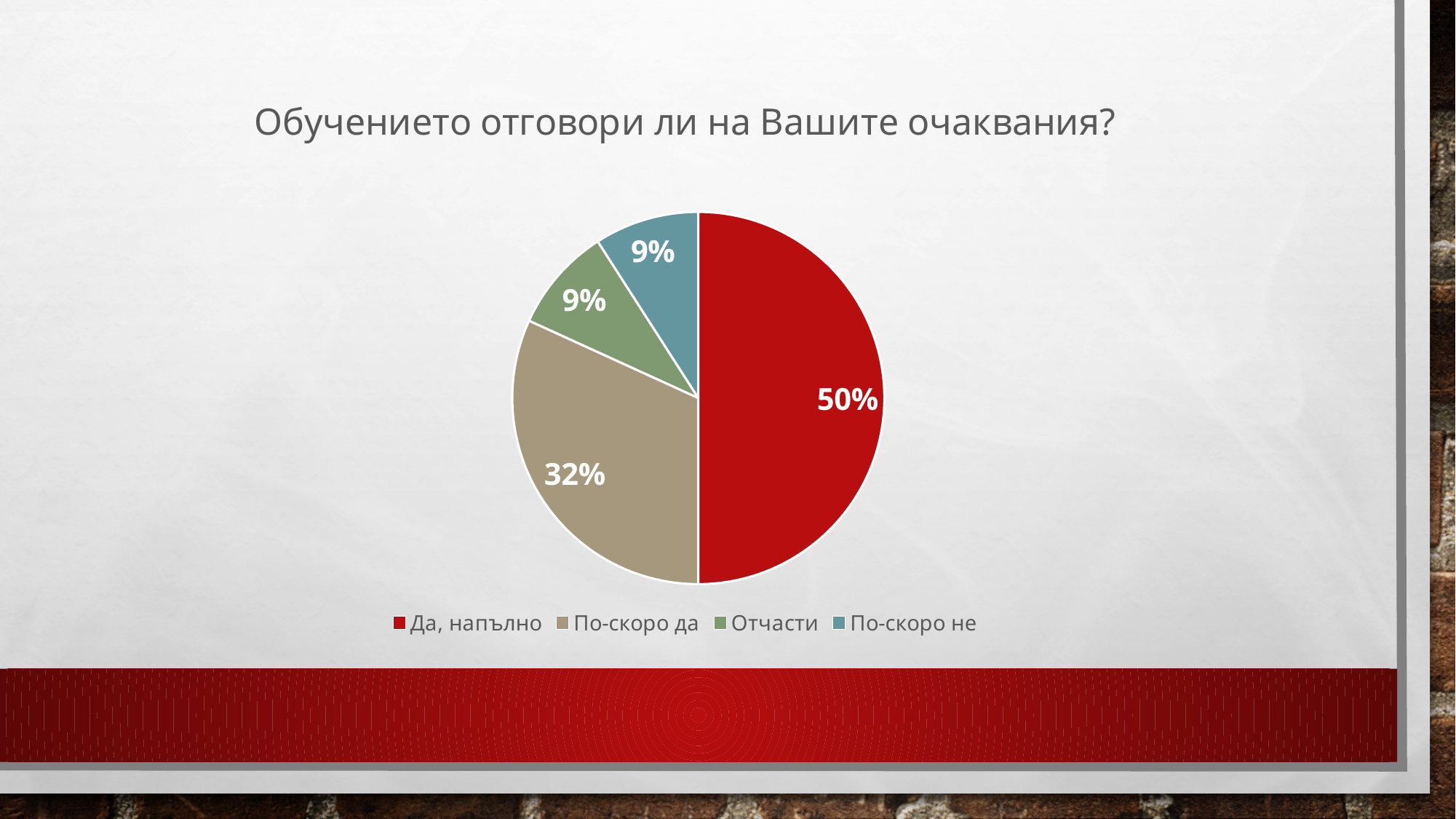
Which is larger, the value for "По-скоро да" or the value for "Отчасти"? По-скоро да What is the value for "По-скоро не"? 9% What kind of chart is shown on the slide? pie chart What is the difference between the values for "Да, напълно" and "По-скоро да"? 18% How many entries does the legend list? 4 What is the value for "По-скоро да"? 32% How many slices does the pie chart have? 4 What is the chart's title? Обучението отговори ли на Вашите очаквания? What colour is the slice for "По-скоро не"? blue What is the value for "Отчасти"? 9% What share of the pie does "Да, напълно" take? 50% Which category has the largest slice of the pie? Да, напълно